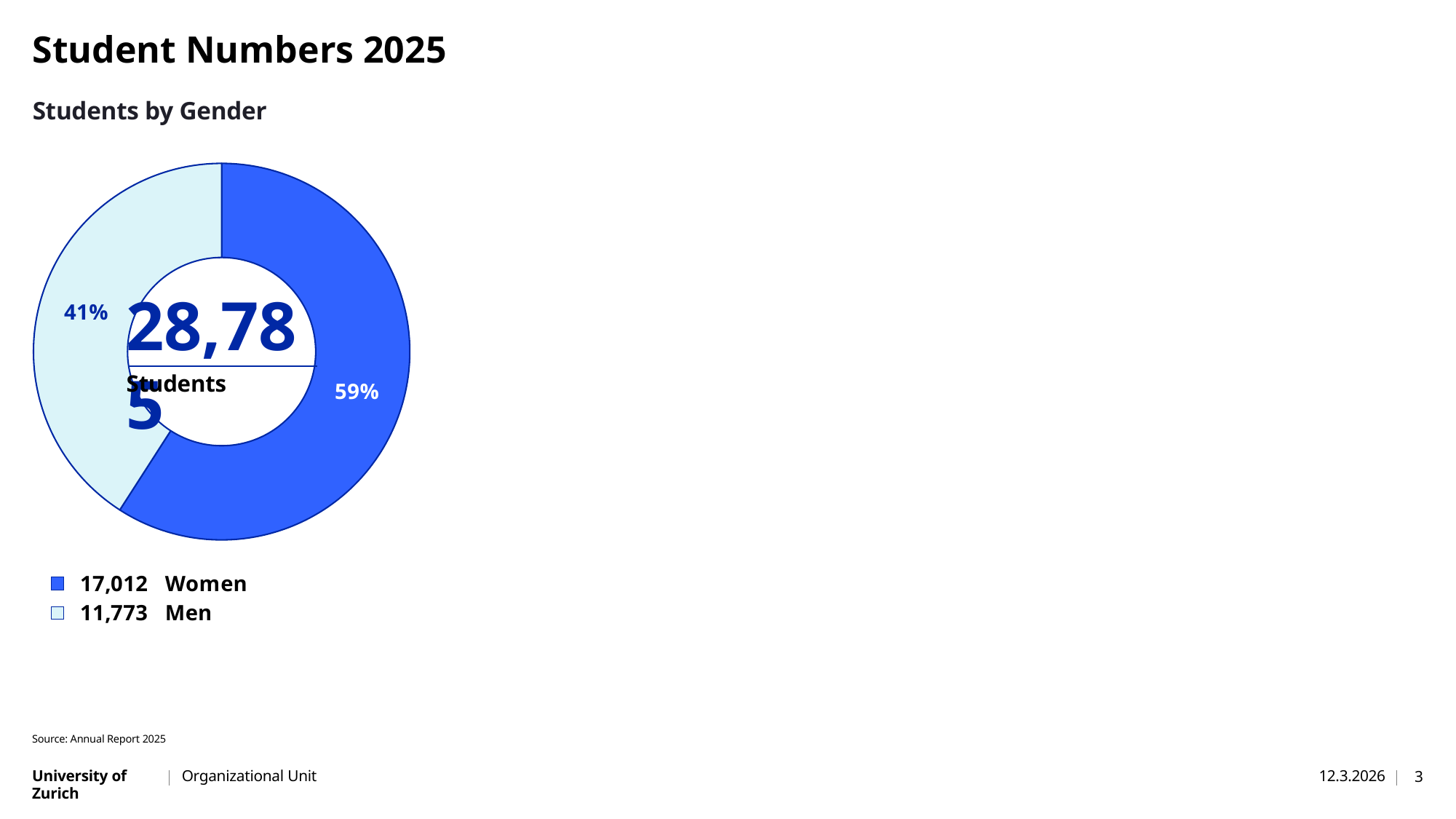
What is the title of the chart? Students by Gender Which gender has the larger number of students? Women What is the total number of students shown in the centre of the chart? 28,785 How many students are men according to the legend? 11,773 Which gender has the smaller number of students? Men What kind of chart is shown on the slide? Donut (pie) chart How many students are women according to the legend? 17,012 How many categories does the chart show? 2 Is the number of women students larger than the number of men students? Yes How many more women than men are there among the students? 5,239 What percentage of students are women? 59% What percentage of students are men? 41%